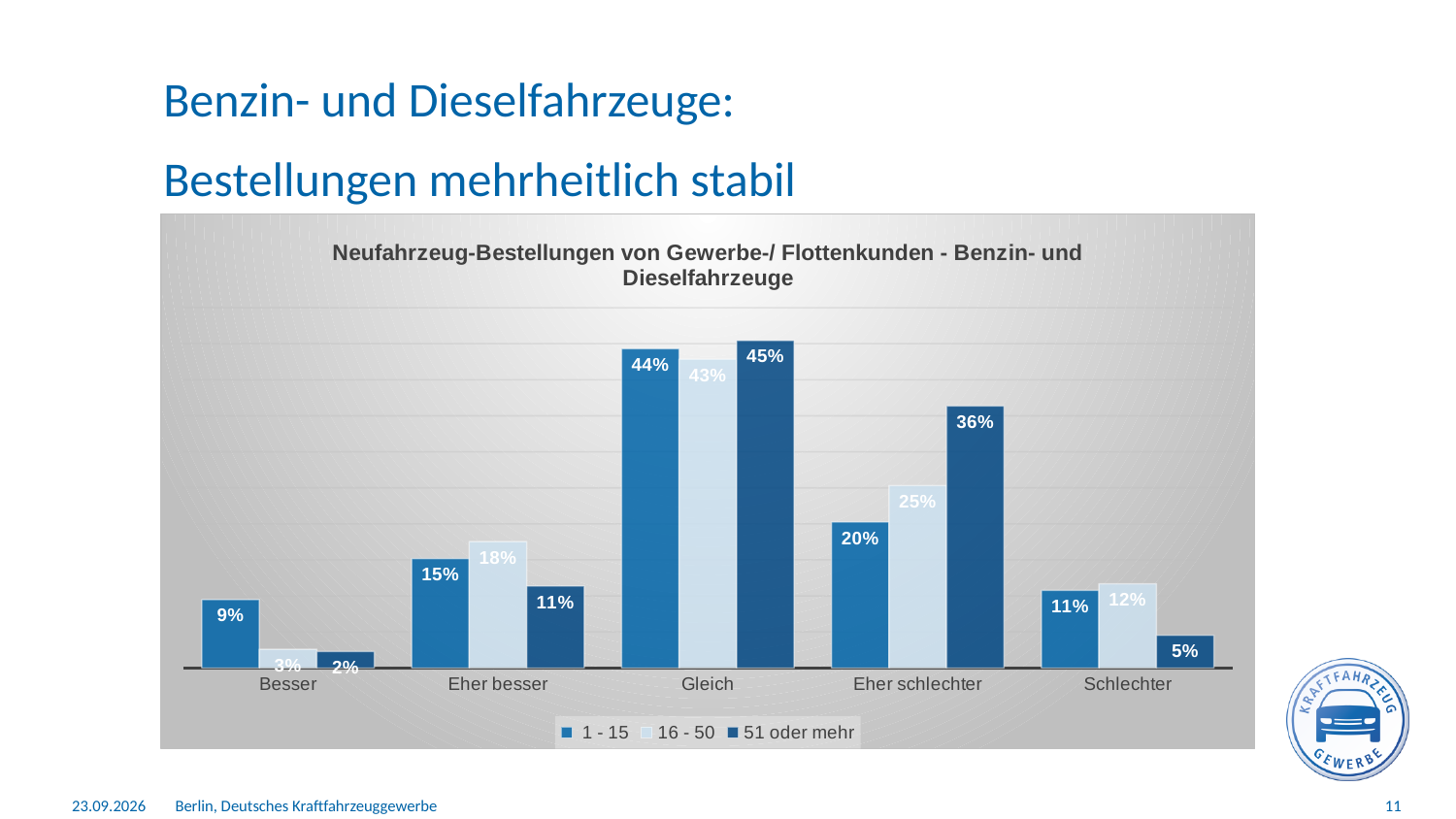
How many series does the legend list? 3 Which category has the highest value in the "51 oder mehr" series? Gleich What is the value for "Gleich" in the "51 oder mehr" series? 45% What is the value for "Eher besser" in the "16 - 50" series? 18% What is the difference between the "51 oder mehr" and "1 - 15" values for "Eher schlechter"? 16% What kind of chart is shown on the slide? Bar chart What is the value for "Besser" in the "1 - 15" series? 9% What is the value for "Eher schlechter" in the "16 - 50" series? 25% For "Schlechter", which series has the larger value: "1 - 15" or "51 oder mehr"? 1 - 15 What is the title of the chart? Neufahrzeug-Bestellungen von Gewerbe-/ Flottenkunden - Benzin- und Dieselfahrzeuge Which category has the lowest value in the "16 - 50" series? Besser How many categories are shown on the x axis? 5